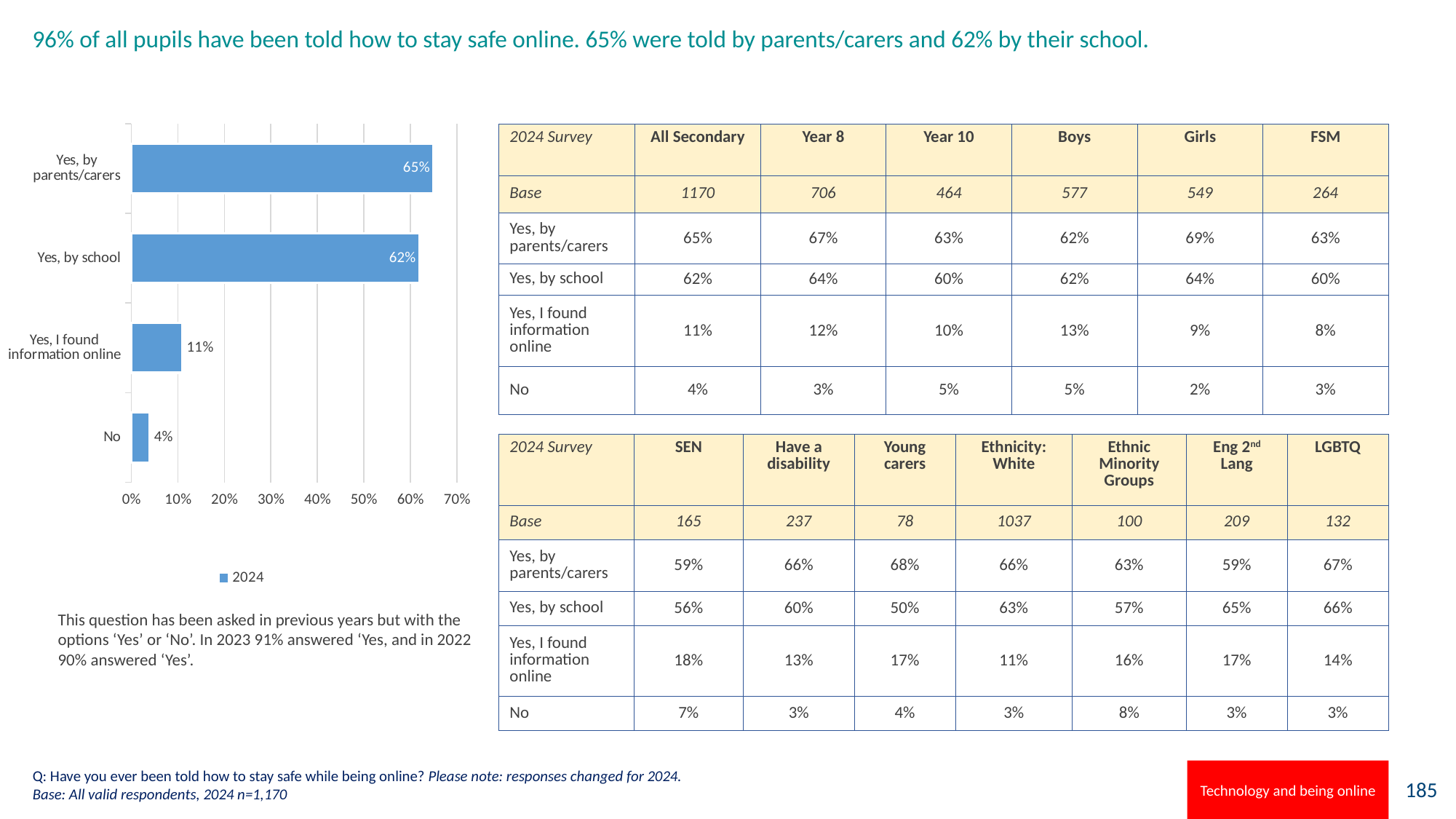
What is the difference between the 'Yes, by parents/carers' and 'Yes, by school' values? 3 percentage points Which is larger: 'Yes, I found information online' or 'No'? Yes, I found information online Which response category has the highest value in the bar chart? Yes, by parents/carers What percentage of pupils said they found information online about staying safe? 11% How many response categories are shown in the bar chart? 4 What percentage of pupils answered 'No' to being told how to stay safe online? 4% What year does the legend entry for the bar chart refer to? 2024 What type of chart is shown on the slide? Bar chart Which response category has the lowest value in the bar chart? No What percentage of pupils said they were told how to stay safe online by parents/carers? 65% What percentage of pupils said they were told how to stay safe online by school? 62% How many series does the chart legend list? 1